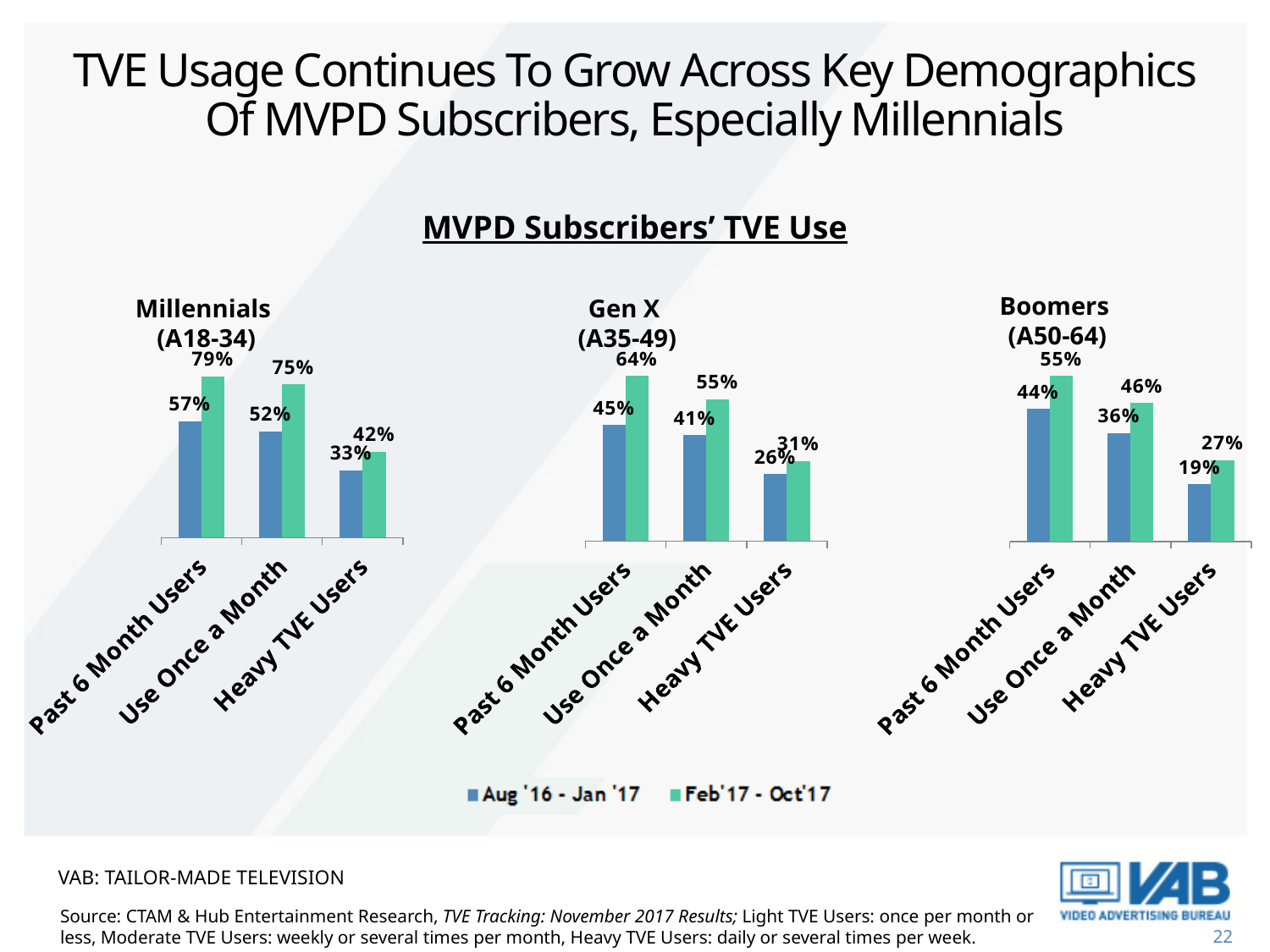
What is the title shown above the three charts? MVPD Subscribers' TVE Use How many categories are shown on the x axis of the Gen X (A35-49) chart? 3 In the Millennials (A18-34) chart, what is the difference between the Feb'17 - Oct'17 and Aug '16 - Jan '17 values for Past 6 Month Users? 22% How many series does the legend list? 2 In the Gen X (A35-49) chart, what is the Aug '16 - Jan '17 value for Use Once a Month? 41% In the Boomers (A50-64) chart, which category has the highest Feb'17 - Oct'17 value? Past 6 Month Users In the Boomers (A50-64) chart, which is larger for Use Once a Month: the Aug '16 - Jan '17 value or the Feb'17 - Oct'17 value? Feb'17 - Oct'17 In the Gen X (A35-49) chart, what is the difference between the Feb'17 - Oct'17 and Aug '16 - Jan '17 values for Heavy TVE Users? 5% What kind of chart is the Millennials (A18-34) chart? Bar chart In the Boomers (A50-64) chart, what is the Aug '16 - Jan '17 value for Heavy TVE Users? 19% In the Millennials (A18-34) chart, which category has the lowest Feb'17 - Oct'17 value? Heavy TVE Users In the Millennials (A18-34) chart, what is the Feb'17 - Oct'17 value for Past 6 Month Users? 79%